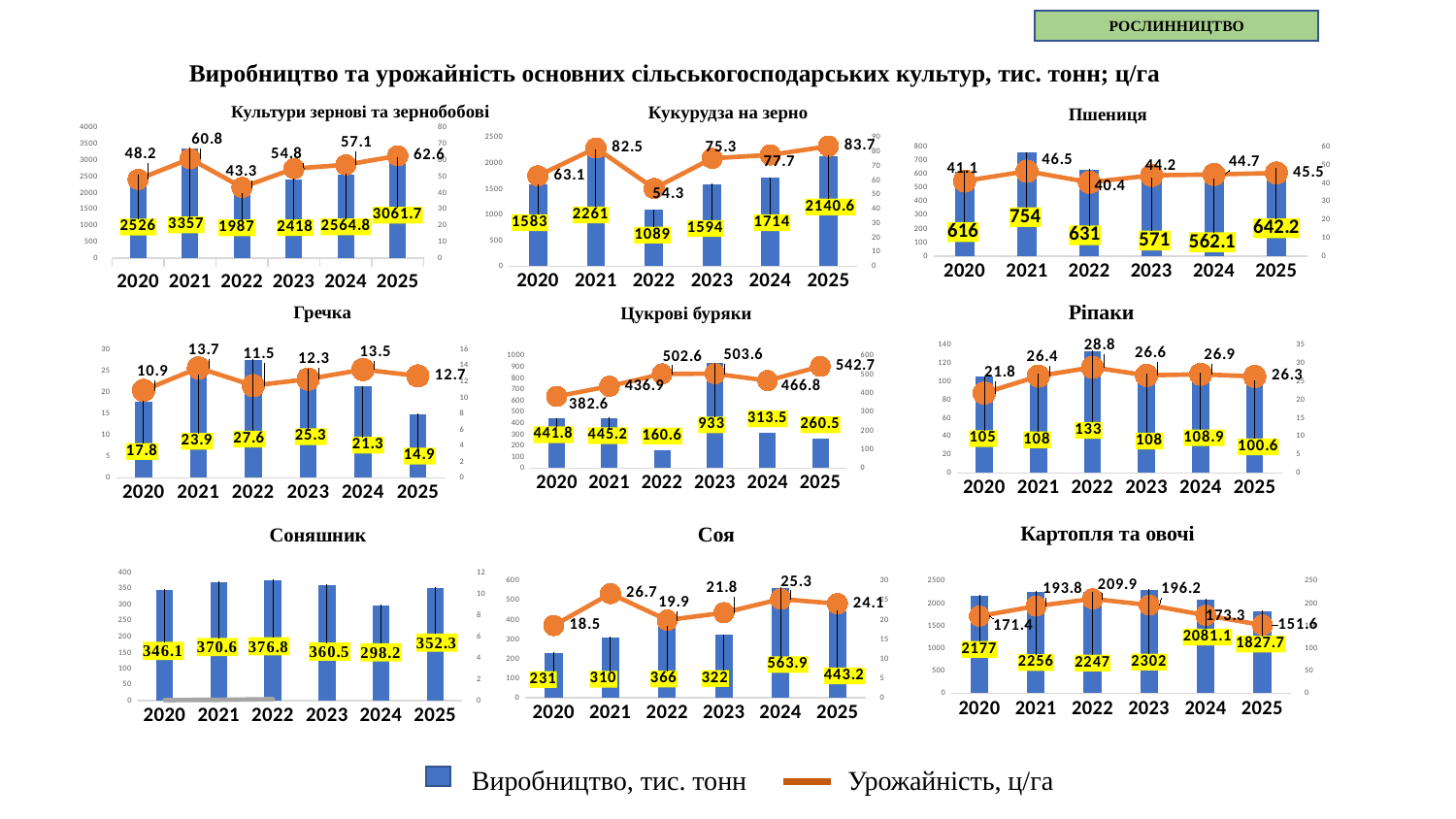
In the chart titled "Соняшник", how many years are shown on the x axis? 6 In the chart titled "Кукурудза на зерно", what is the production value (тис. тонн) for 2022? 1089 In the chart titled "Соняшник", what is the production value for 2024? 298.2 In the chart titled "Картопля та овочі", does the production value rise or fall from 2023 to 2025? Fall In the chart titled "Соя", which is larger: the production value for 2024 or for 2025? 2024 In the chart titled "Пшениця", what is the yield (ц/га) for 2021? 46.5 In the chart titled "Культури зернові та зернобобові", what is the difference between the production values for 2021 and 2022? 1370 In the chart titled "Гречка", which year has the lowest production value? 2025 What kind of chart is the one titled "Ріпаки"? Combined bar and line chart In the chart titled "Цукрові буряки", which year has the highest production value? 2023 In the chart titled "Ріпаки", what is the yield (ц/га) for 2022? 28.8 How many series does the legend at the bottom of the slide list? 2